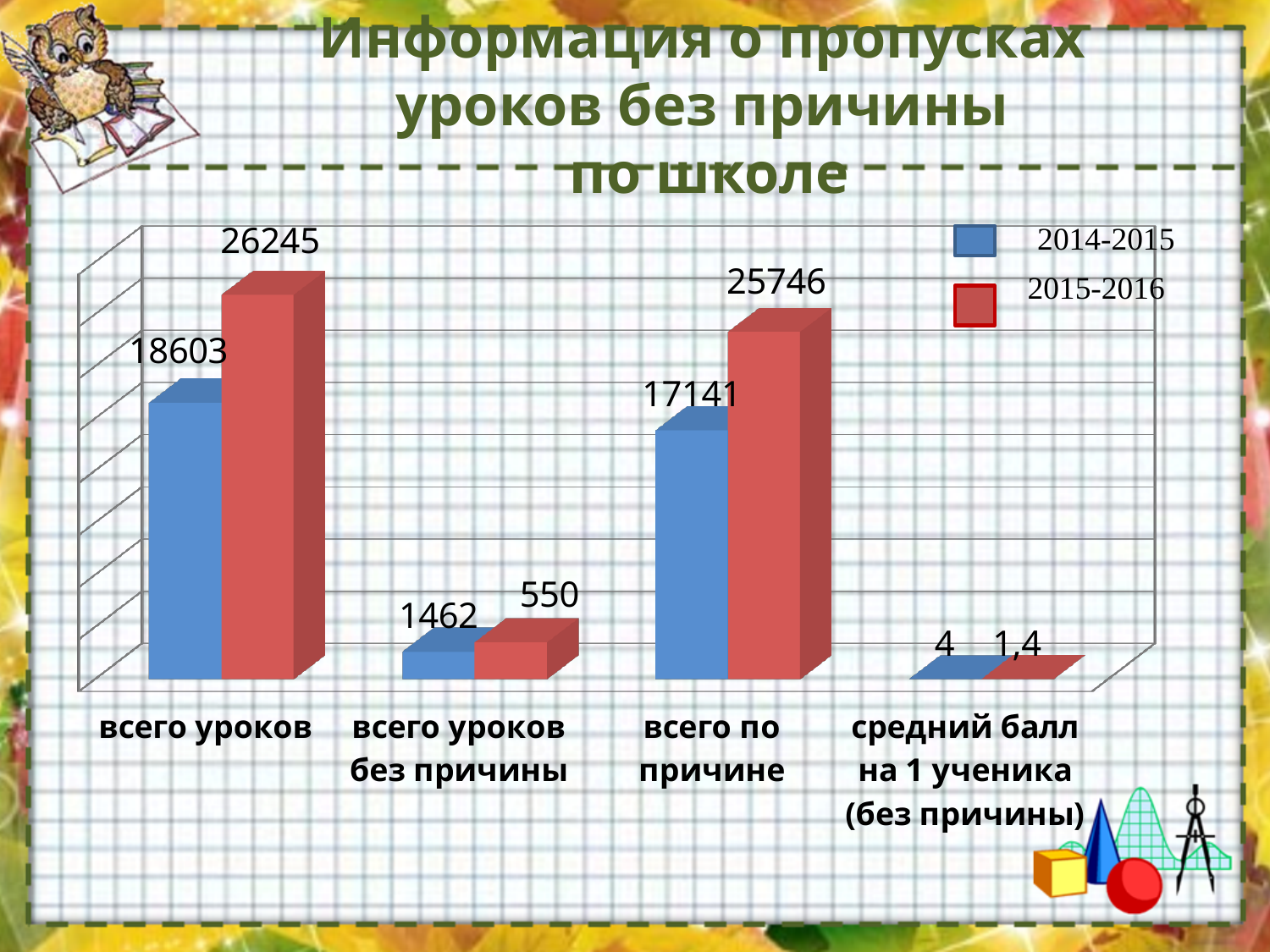
Which category has the lowest value in the 2015-2016 series? средний балл на 1 ученика (без причины) How many series does the legend list? 2 What kind of chart is shown on the slide? bar chart What is the difference between the 2015-2016 and 2014-2015 values for 'всего уроков'? 7642 What is the difference between the 2014-2015 and 2015-2016 values for 'всего уроков без причины'? 912 What is the value for 'всего уроков' in the 2015-2016 series? 26245 For 'всего по причине', which series has the larger value, 2014-2015 or 2015-2016? 2015-2016 What is the value for 'средний балл на 1 ученика (без причины)' in the 2015-2016 series? 1,4 What is the value for 'всего по причине' in the 2015-2016 series? 25746 How many categories are shown on the x axis? 4 What is the value for 'всего уроков без причины' in the 2014-2015 series? 1462 Which category has the highest value in the 2014-2015 series? всего уроков